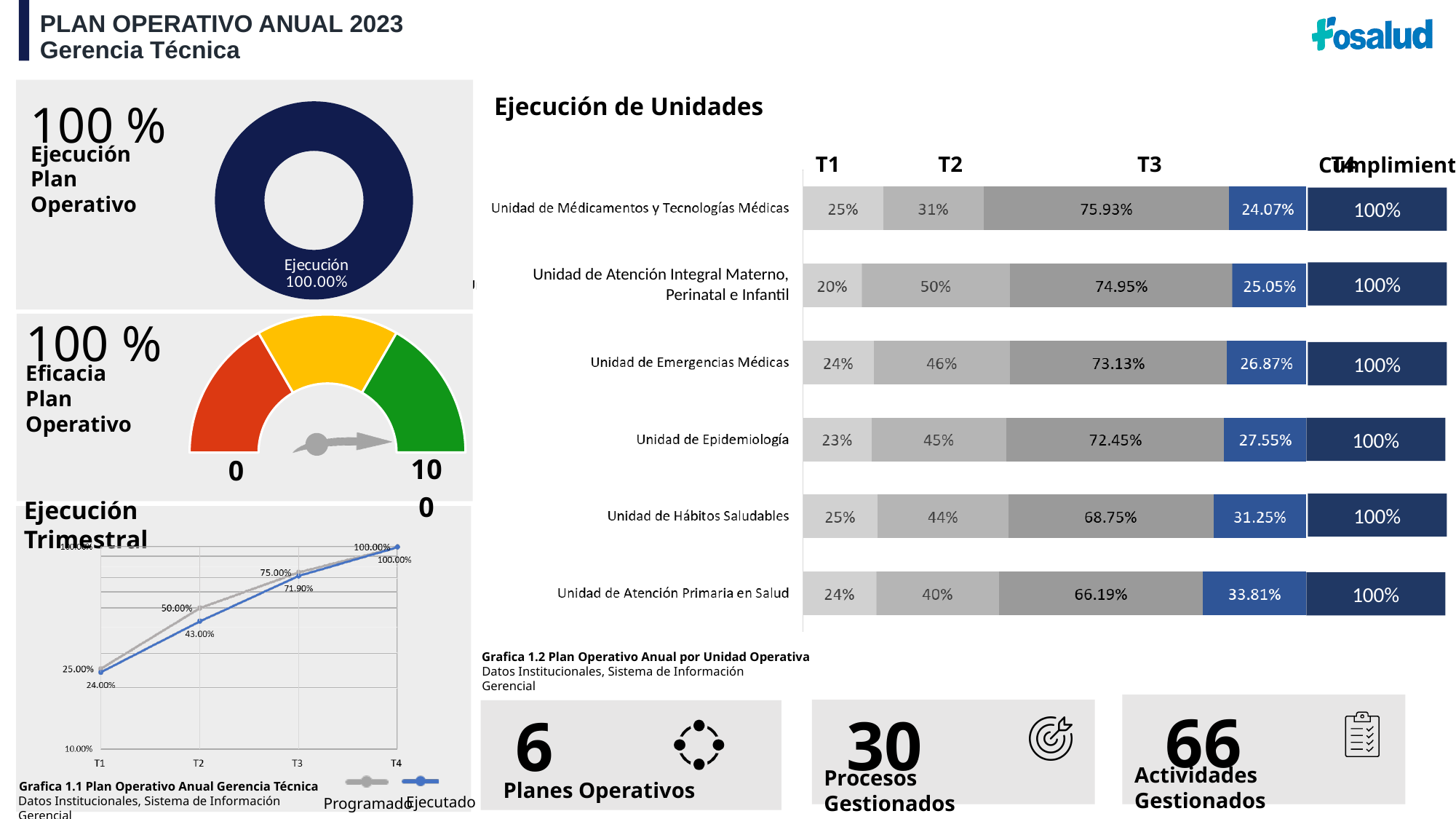
In the 'Ejecución Trimestral' line chart, what is the Ejecutado value at T3? 71.90% In the 'Ejecución de Unidades' chart, which unit has the lowest T3 value? Unidad de Atención Primaria en Salud In the 'Ejecución Trimestral' line chart, how many series does the legend list? 2 In the 'Ejecución de Unidades' chart, what is the T4 value for Unidad de Atención Primaria en Salud? 33.81% In the 'Ejecución Trimestral' line chart, do the Ejecutado values rise or fall from T1 to T4? rise In the 'Ejecución de Unidades' chart, which unit has the highest T3 value? Unidad de Médicamentos y Tecnologías Médicas In the 'Ejecución Trimestral' line chart, what is the difference between the Programado and Ejecutado values at T2? 7.00% In the 'Ejecución Trimestral' line chart, what is the Programado value at T2? 50.00% In the 'Ejecución de Unidades' chart, what is the T3 value for Unidad de Emergencias Médicas? 73.13% In the 'Ejecución de Unidades' chart, is the T2 value for Unidad de Atención Integral Materno, Perinatal e Infantil larger or smaller than the T2 value for Unidad de Epidemiología? larger In the 'Ejecución de Unidades' chart, how many units are listed? 6 What value is shown as the Ejecución label on the donut chart at the top left? 100.00%